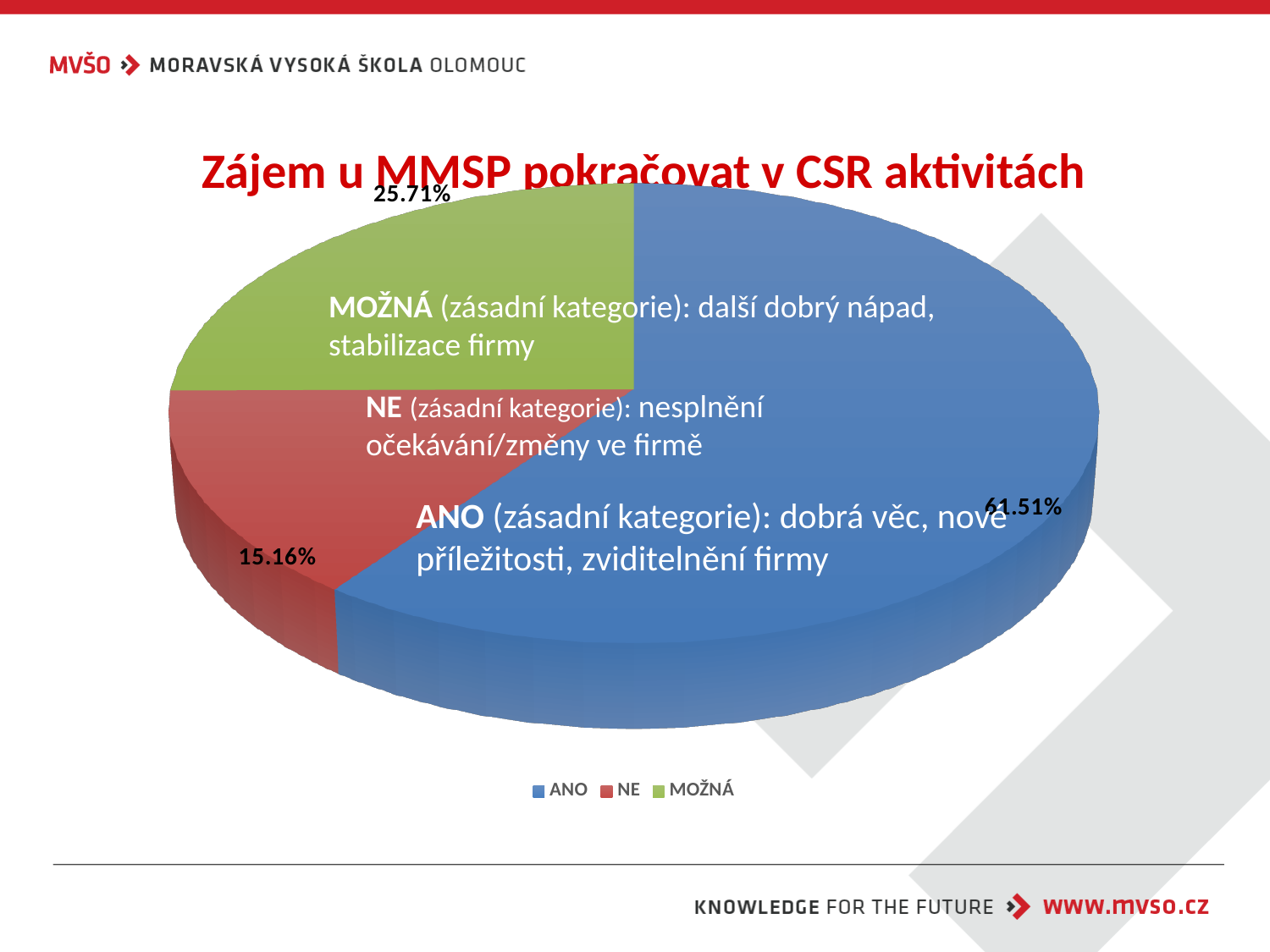
What type of chart is shown on the slide? pie chart What is the value for MOŽNÁ in the pie chart? 25.71% Which category has the smallest share of the pie? NE What is the difference between the shares of ANO and MOŽNÁ? 35.80% What is the title of the chart? Zájem u MMSP pokračovat v CSR aktivitách What is the value for ANO in the pie chart? 61.51% Which category has the largest share of the pie? ANO How many entries does the legend list? 3 Which is larger, the share of NE or the share of MOŽNÁ? MOŽNÁ What is the value for NE in the pie chart? 15.16% How many slices does the pie chart have? 3 What is the difference between the shares of MOŽNÁ and NE? 10.55%